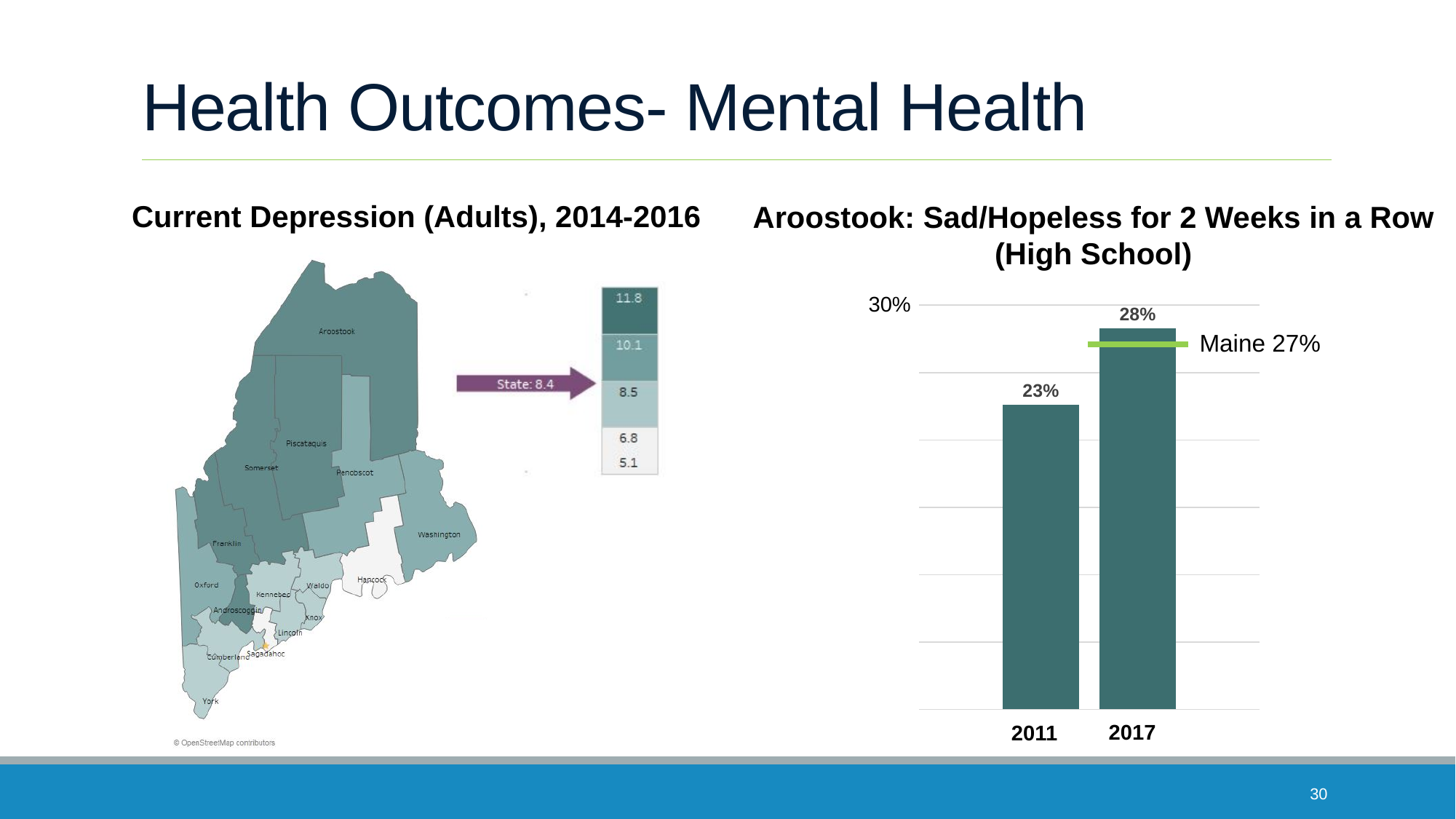
In the bar chart on the right, which year has the highest value? 2017 In the bar chart 'Aroostook: Sad/Hopeless for 2 Weeks in a Row (High School)', what is the value for 2017? 28% In the bar chart 'Aroostook: Sad/Hopeless for 2 Weeks in a Row (High School)', what is the value for 2011? 23% In the bar chart on the right, which is larger, the value for 2011 or the value for 2017? 2017 In the bar chart on the right, which year has the lowest value? 2011 In the bar chart on the right, is the value for 2017 greater or less than 30%? less In the bar chart on the right, does the value rise or fall from 2011 to 2017? rise In the bar chart on the right, what is the difference between the 2017 value and the 2011 value? 5 percentage points In the map 'Current Depression (Adults), 2014-2016', what state value is shown in the purple arrow? 8.4 What kind of chart is shown on the right side of the slide? bar chart How many years (bars) are shown in the bar chart on the right? 2 In the bar chart on the right, what Maine value is marked by the green reference line? 27%